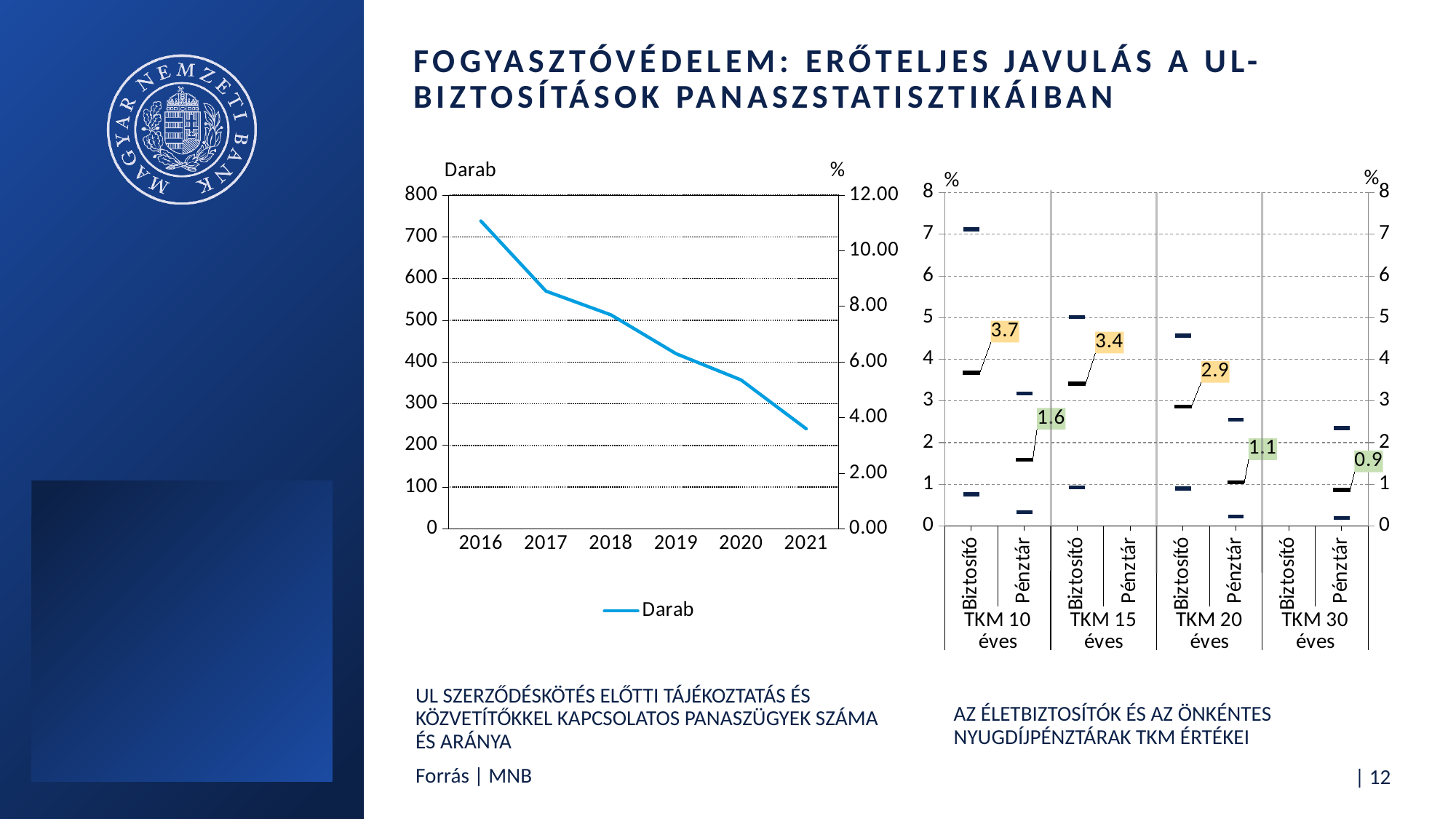
How many series does the legend of the left chart list? 1 In the left chart, does the Darab line rise or fall from 2016 to 2021? fall In the right chart (TKM értékei), what is the labelled value for Pénztár in the TKM 30 éves group? 0.9 What is the only legend entry shown under the left chart? Darab How many years are shown on the x axis of the left chart? 6 What kind of chart is the left chart (UL szerződéskötés előtti tájékoztatás ... panaszügyek száma és aránya)? line chart In the right chart (TKM értékei), what is the labelled value for Biztosító in the TKM 10 éves group? 3.7 In the right chart (TKM értékei), which labelled value is larger: Biztosító in TKM 20 éves or Pénztár in TKM 20 éves? Biztosító (2.9) In the left chart, is the Darab value for 2016 greater or less than 700? greater In the right chart (TKM értékei), what is the labelled value for Biztosító in the TKM 15 éves group? 3.4 In the left chart, is the Darab value for 2021 greater or less than 300? less In the right chart (TKM értékei), what is the difference between the labelled Biztosító value (3.7) and the labelled Pénztár value (1.6) in the TKM 10 éves group? 2.1